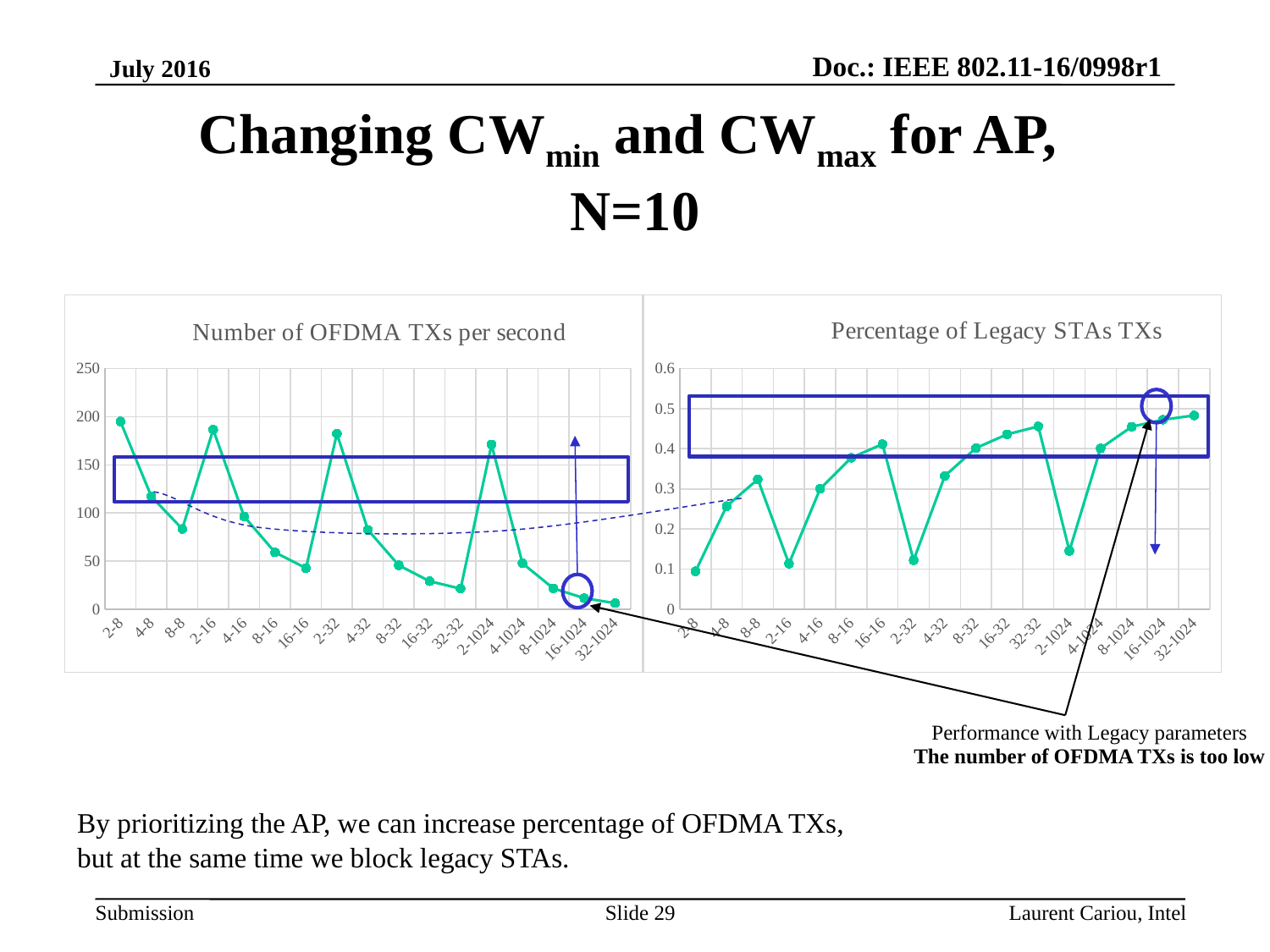
In the 'Number of OFDMA TXs per second' chart, is the value for 16-16 greater or less than 50? less What type of chart is the left chart titled 'Number of OFDMA TXs per second'? line chart In the 'Percentage of Legacy STAs TXs' chart, is the value for 32-32 greater or less than 0.4? greater In the 'Percentage of Legacy STAs TXs' chart, is the value for 2-8 greater or less than 0.2? less How many categories are plotted on the x axis of the 'Number of OFDMA TXs per second' chart? 17 In the 'Number of OFDMA TXs per second' chart, which is larger, the value for 2-8 or the value for 8-8? 2-8 What is the title of the right chart on the slide? Percentage of Legacy STAs TXs In the 'Percentage of Legacy STAs TXs' chart, which is larger, the value for 32-32 or the value for 2-1024? 32-32 What is the first category label on the x axis of the 'Percentage of Legacy STAs TXs' chart? 2-8 In the 'Number of OFDMA TXs per second' chart, do the values rise or fall from 2-1024 to 32-1024? fall